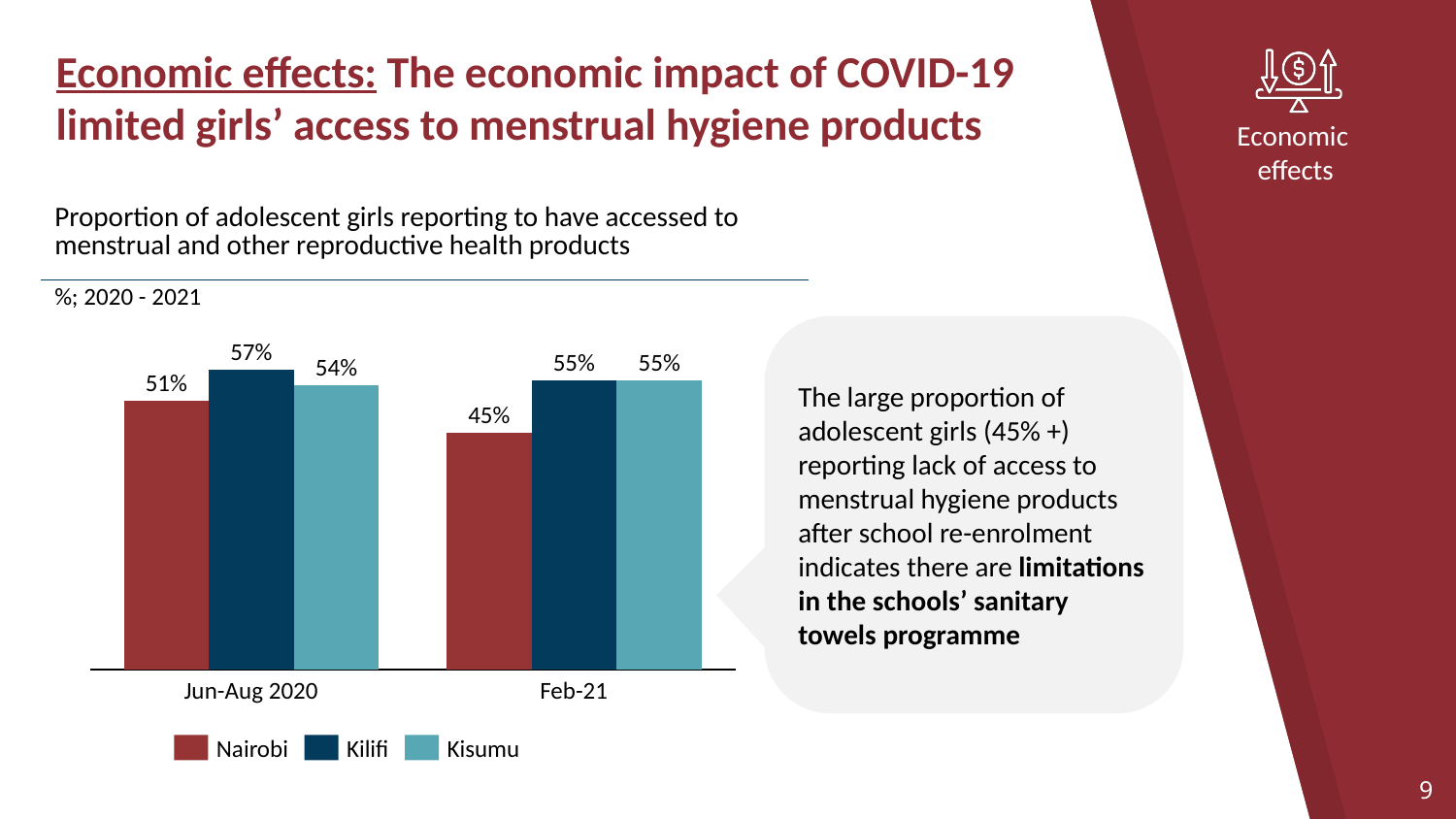
Which county had the highest proportion in Jun-Aug 2020? Kilifi How many series does the legend list? 3 What is the value for Kilifi in Feb-21? 55% What percentage of adolescent girls in Nairobi reported accessing menstrual and other reproductive health products in Jun-Aug 2020? 51% What is the value for Kisumu in Jun-Aug 2020? 54% Which colour represents Kilifi in the chart? Dark blue By how many percentage points did the Nairobi value fall from Jun-Aug 2020 to Feb-21? 6 What is the value for Nairobi in Feb-21? 45% What kind of chart is shown on the slide? Bar chart Which county had the lowest proportion in Feb-21? Nairobi Which is larger: the Kisumu value in Jun-Aug 2020 or the Kisumu value in Feb-21? Feb-21 What is the difference between the Kilifi and Nairobi values in Jun-Aug 2020? 6